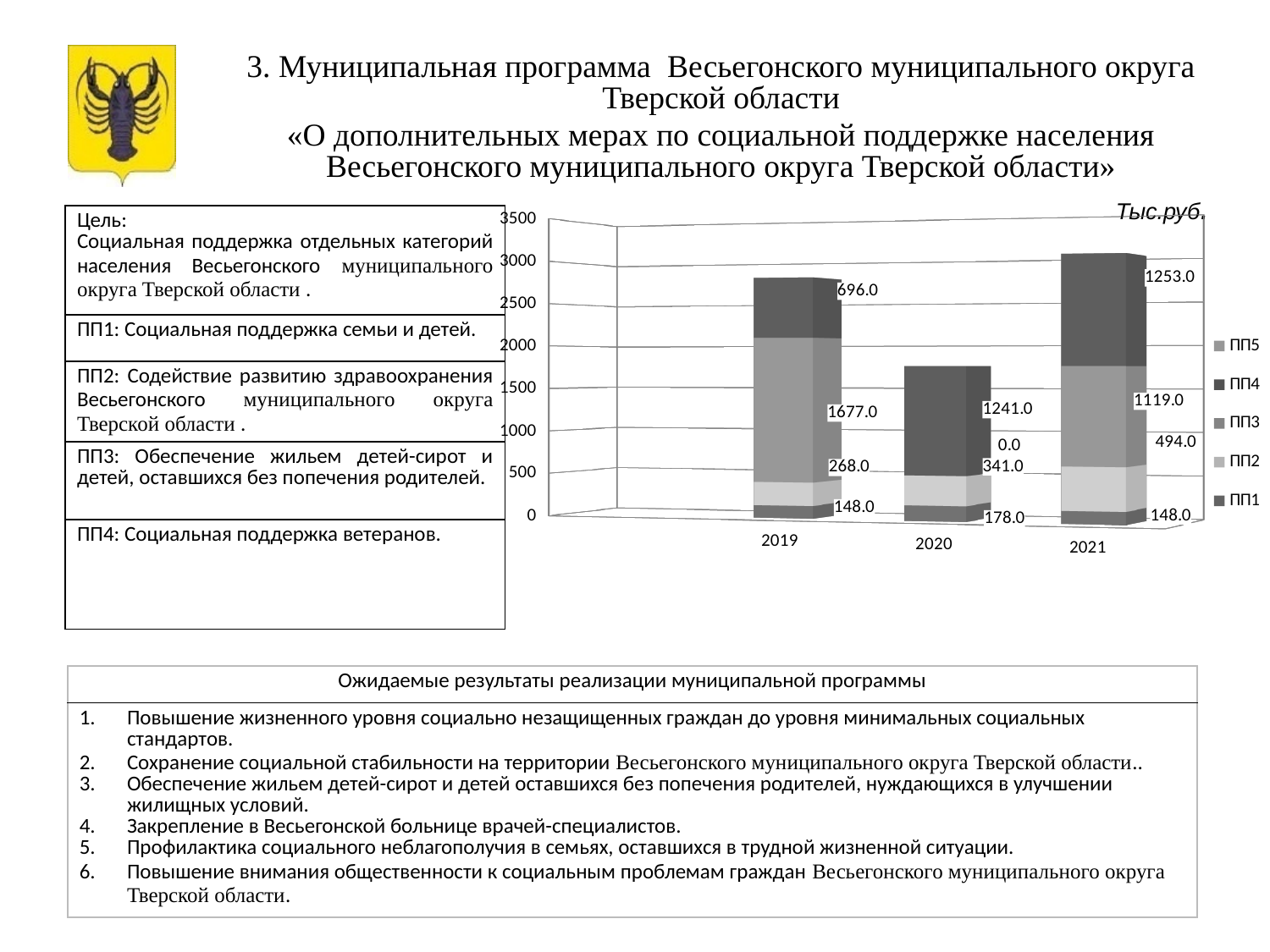
What is the difference between the ПП2 values for 2021 and 2019? 226.0 In which year is the value of ПП2 the highest? 2021 How many series does the chart legend list? 5 What is the value of ПП1 in 2019? 148.0 What unit label is shown above the chart? Тыс.руб. What is the difference between the ПП1 values for 2020 and 2019? 30.0 What is the value of ПП2 in 2020? 341.0 What type of chart is shown on the slide? Stacked bar chart How many years are shown along the x axis of the chart? 3 What is the value of ПП4 in 2021? 1253.0 What is the value of ПП3 in 2019? 1677.0 Which year has the larger value for ПП2, 2019 or 2021? 2021